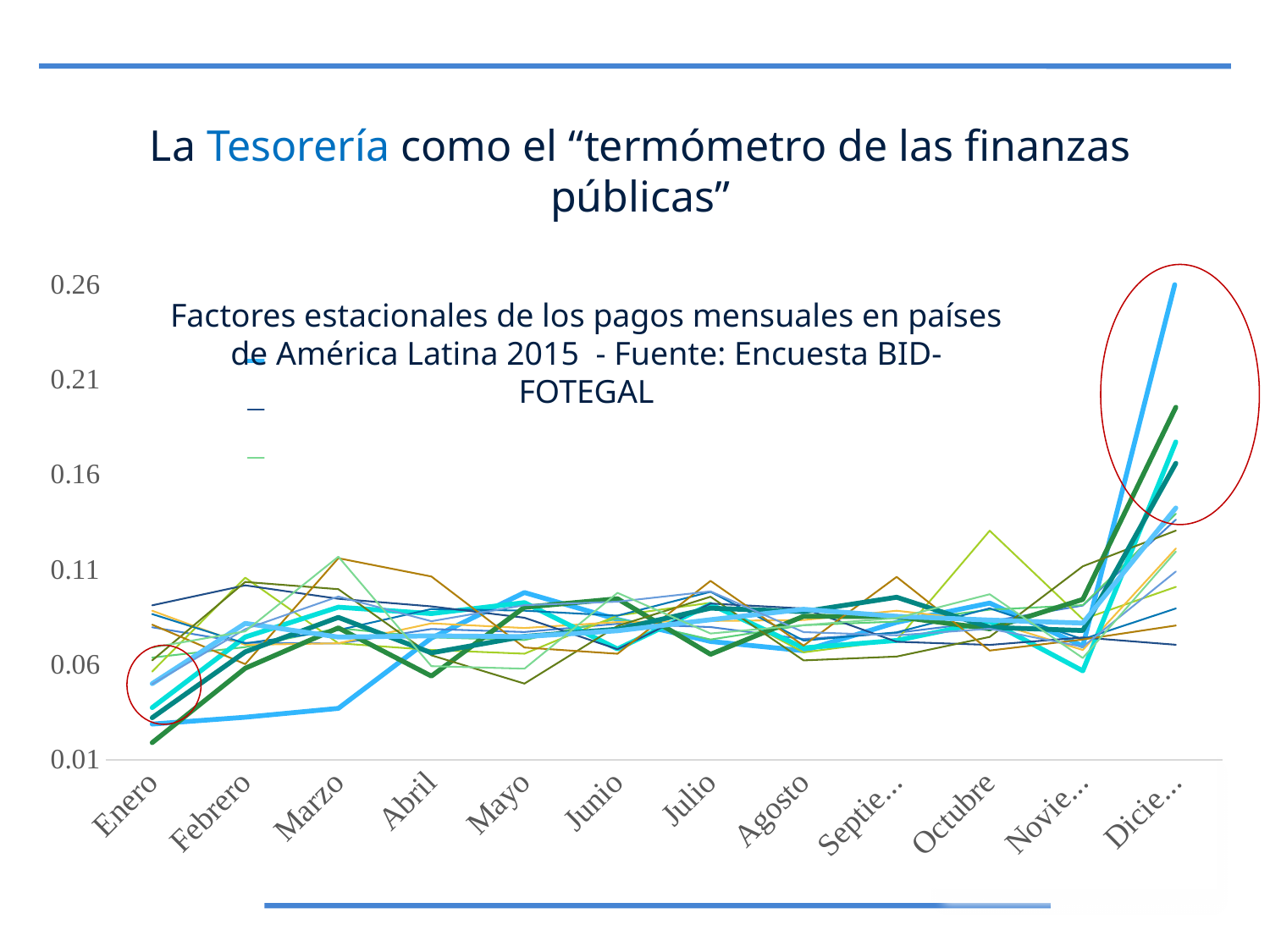
Is the lowest value plotted for Enero greater or less than 0.06? less In which month does the chart reach its lowest plotted value? Enero What is the first month label on the x axis? Enero Is the highest value plotted for Julio greater or less than 0.11? less What kind of chart is shown on the slide? line chart Is the highest value plotted for Diciembre greater or less than 0.21? greater How many months (categories) are shown on the x axis of the chart? 12 Which month has the larger maximum plotted value, Enero or Diciembre? Diciembre What is the title of the chart? Factores estacionales de los pagos mensuales en países de América Latina 2015 - Fuente: Encuesta BID-FOTEGAL Between Noviembre and Diciembre, do the thick highlighted lines rise or fall? rise In which month does the chart reach its highest plotted value? Diciembre